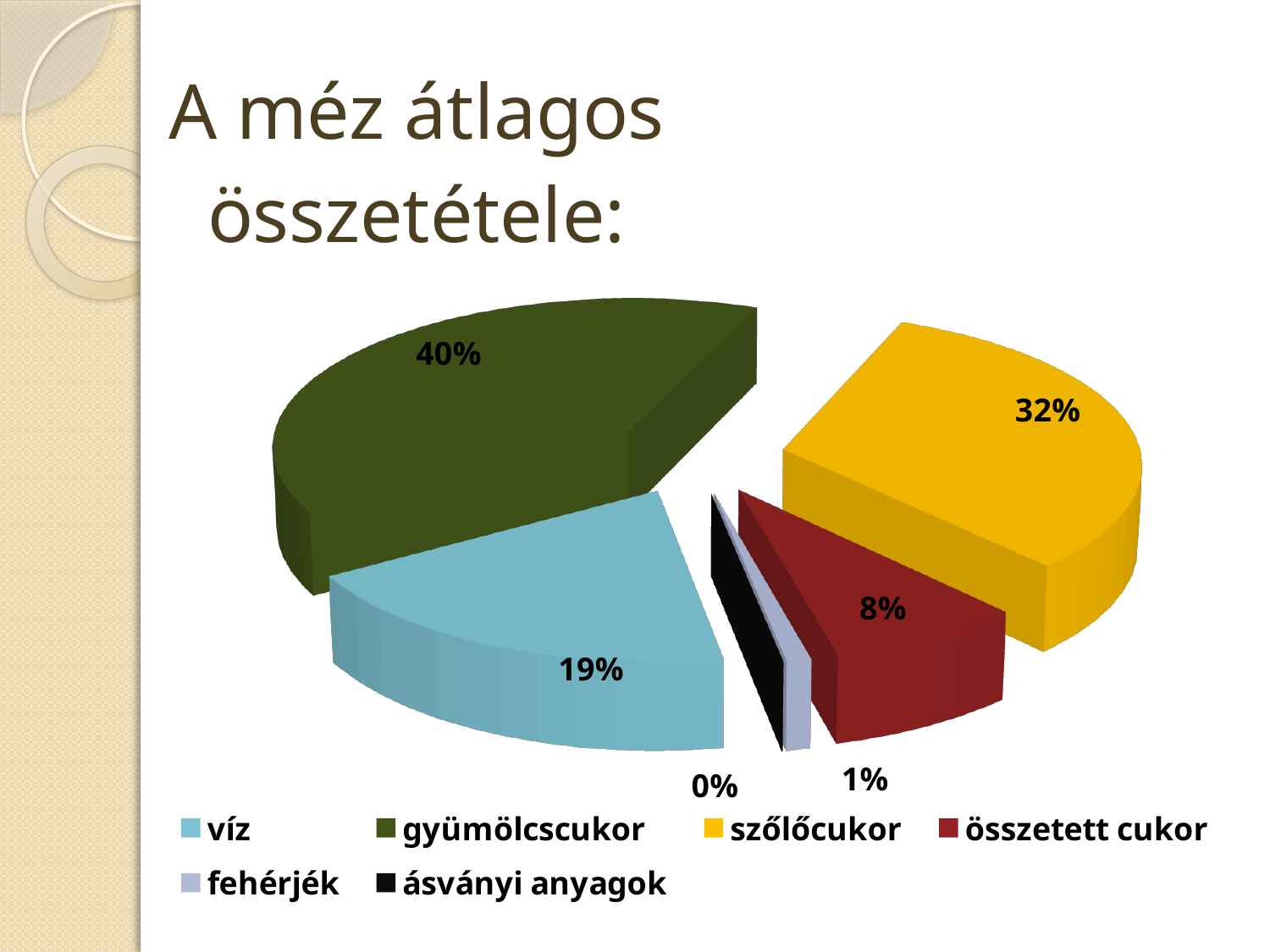
What is the title of the slide containing the chart? A méz átlagos összetétele: What is the difference between the shares of gyümölcscukor and szőlőcukor? 8% What colour is the slice for szőlőcukor? yellow How many categories does the legend list? 6 Which is larger, the slice for szőlőcukor or the slice for víz? szőlőcukor What is the difference between the shares of víz and összetett cukor? 11% What share of the pie does szőlőcukor have? 32% What share of the pie does összetett cukor have? 8% What share of the pie does víz have? 19% Which category has the largest slice of the pie? gyümölcscukor What kind of chart is shown on the slide? pie chart